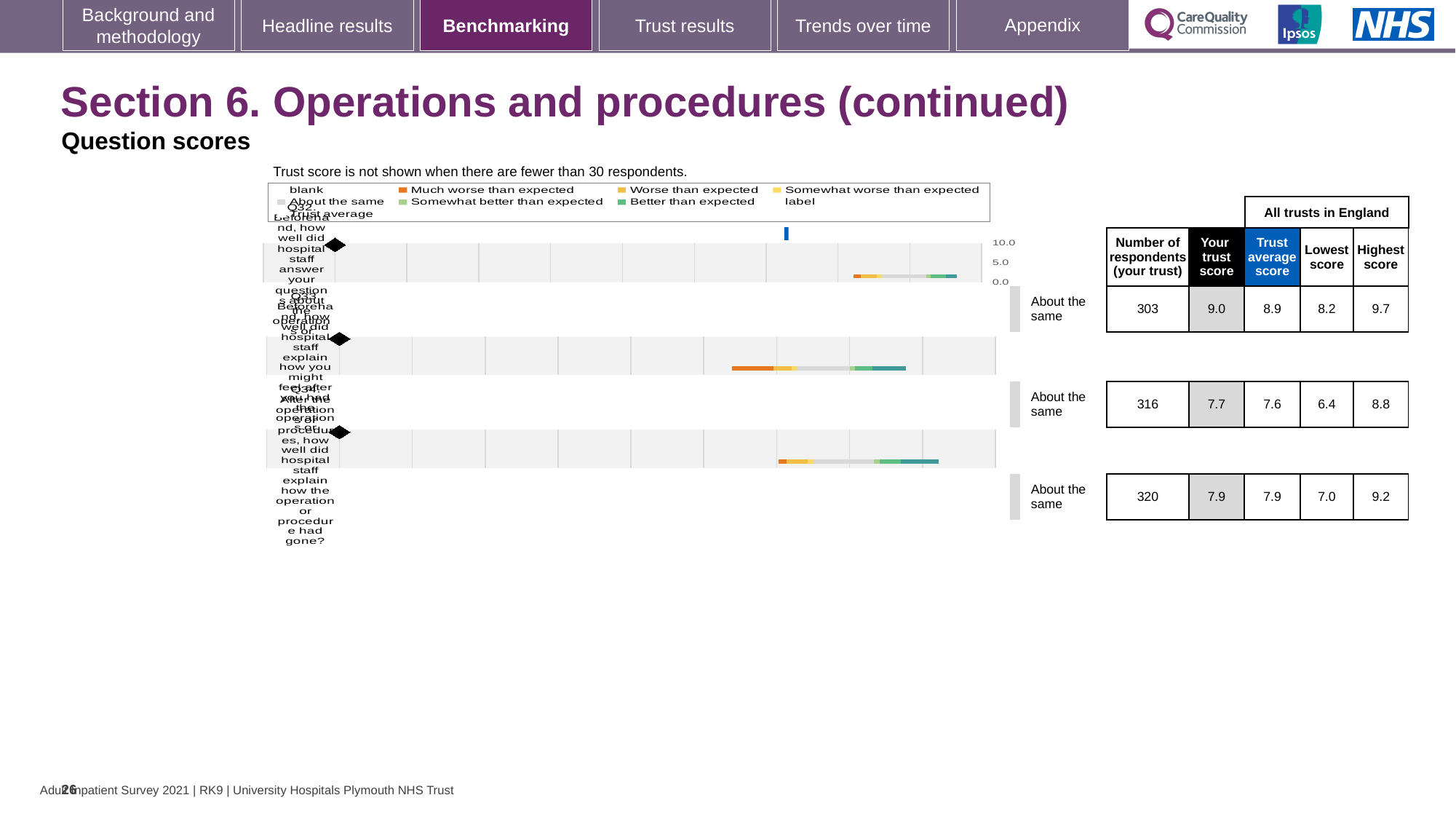
In the legend, what colour represents 'Much worse than expected'? orange For the top chart row, which is larger: your trust score or the trust average score? your trust score (9.0) How many question rows (charts) are shown on the slide? 3 For the top chart row, what is the number of respondents (your trust)? 303 For the top chart row, what is your trust score? 9.0 What is the maximum value shown on the chart's horizontal axis? 10.0 For the third chart row, what is the highest score among all trusts in England? 9.2 Which chart row has the lowest 'Lowest score' value? the second row, 6.4 For the second chart row, what is the difference between the highest score and the lowest score? 2.4 What kind of chart is used for the three question rows on this slide? bar chart Which chart row has the highest number of respondents? the third (bottom) row, 320 For the second chart row, what is the trust average score? 7.6